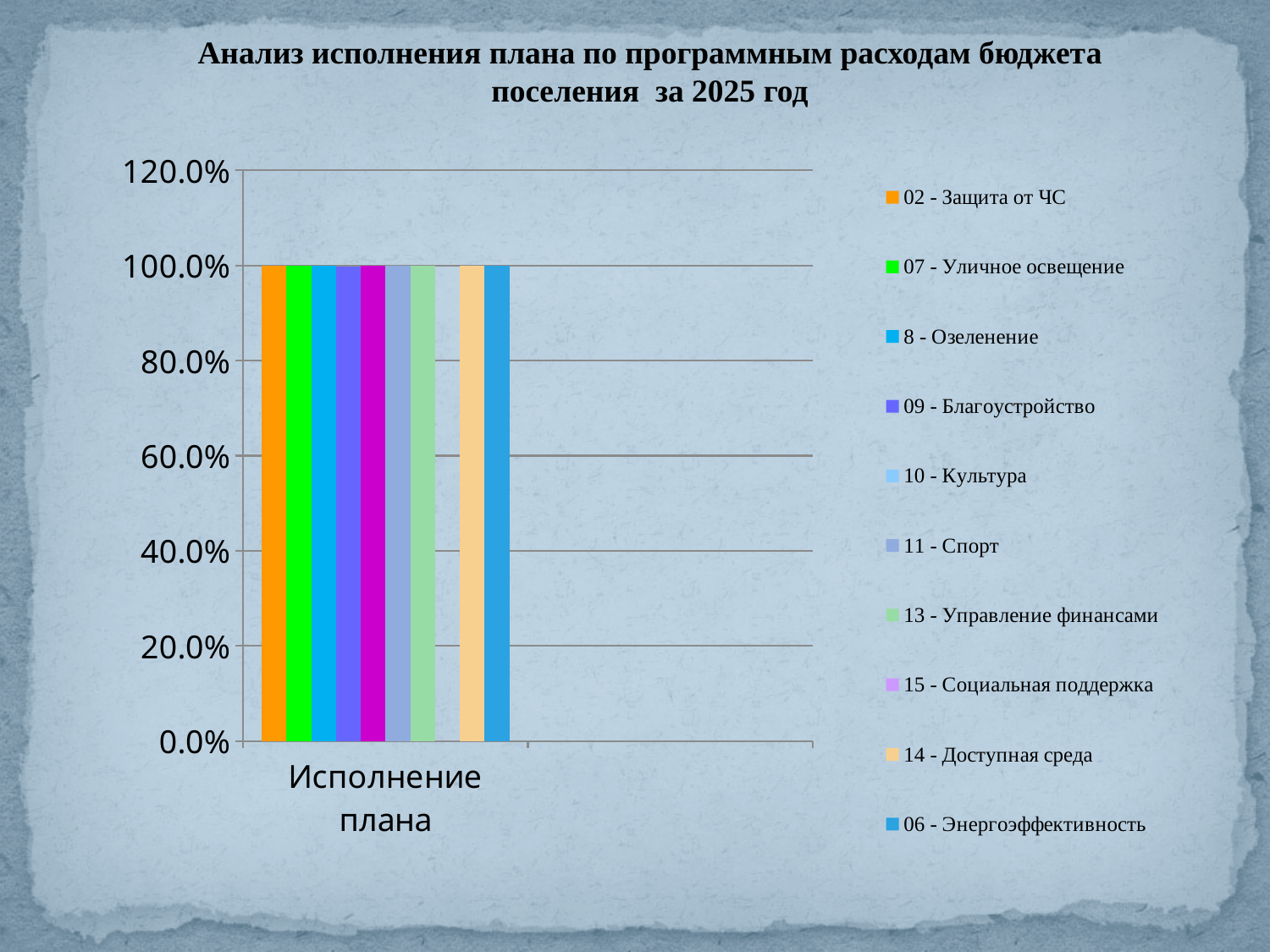
Is the value for 07 - Уличное освещение greater or less than 80.0%? greater What is the value for 02 - Защита от ЧС? 100.0% How many categories are shown on the x axis? 1 What is the value for 06 - Энергоэффективность? 100.0% Is the value for 8 - Озеленение greater or less than 60.0%? greater What kind of chart is shown on the slide? bar chart What is the value for 13 - Управление финансами? 100.0% Is the value for 14 - Доступная среда greater or less than 120.0%? less How many series does the legend list? 10 What is the category label shown on the x axis? Исполнение плана What is the title of the chart? Анализ исполнения плана по программным расходам бюджета поселения за 2025 год